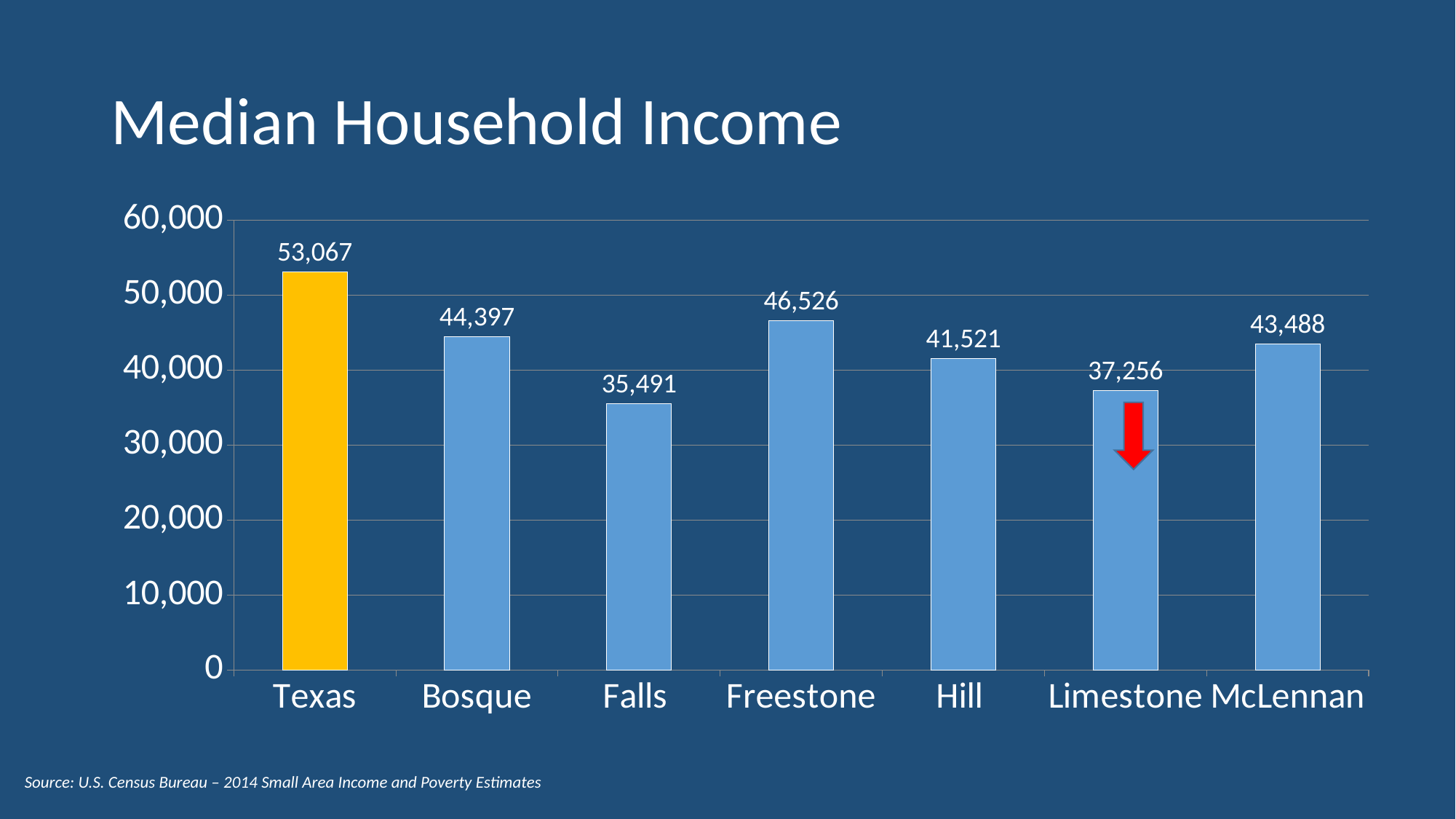
How many categories are shown on the chart? 7 Which has a higher median household income, Hill or McLennan? McLennan What is the median household income for Texas? 53,067 What kind of chart is shown on the slide? Bar chart What is the difference between the median household income of Bosque and McLennan? 909 What is the median household income for Limestone? 37,256 Is the value for Falls greater or less than 40,000? less What is the median household income for Freestone? 46,526 What is the difference between the median household income of Texas and Limestone? 15,811 Which bar is coloured differently (yellow) from the others? Texas Which category has the lowest median household income? Falls Which category has the highest median household income? Texas